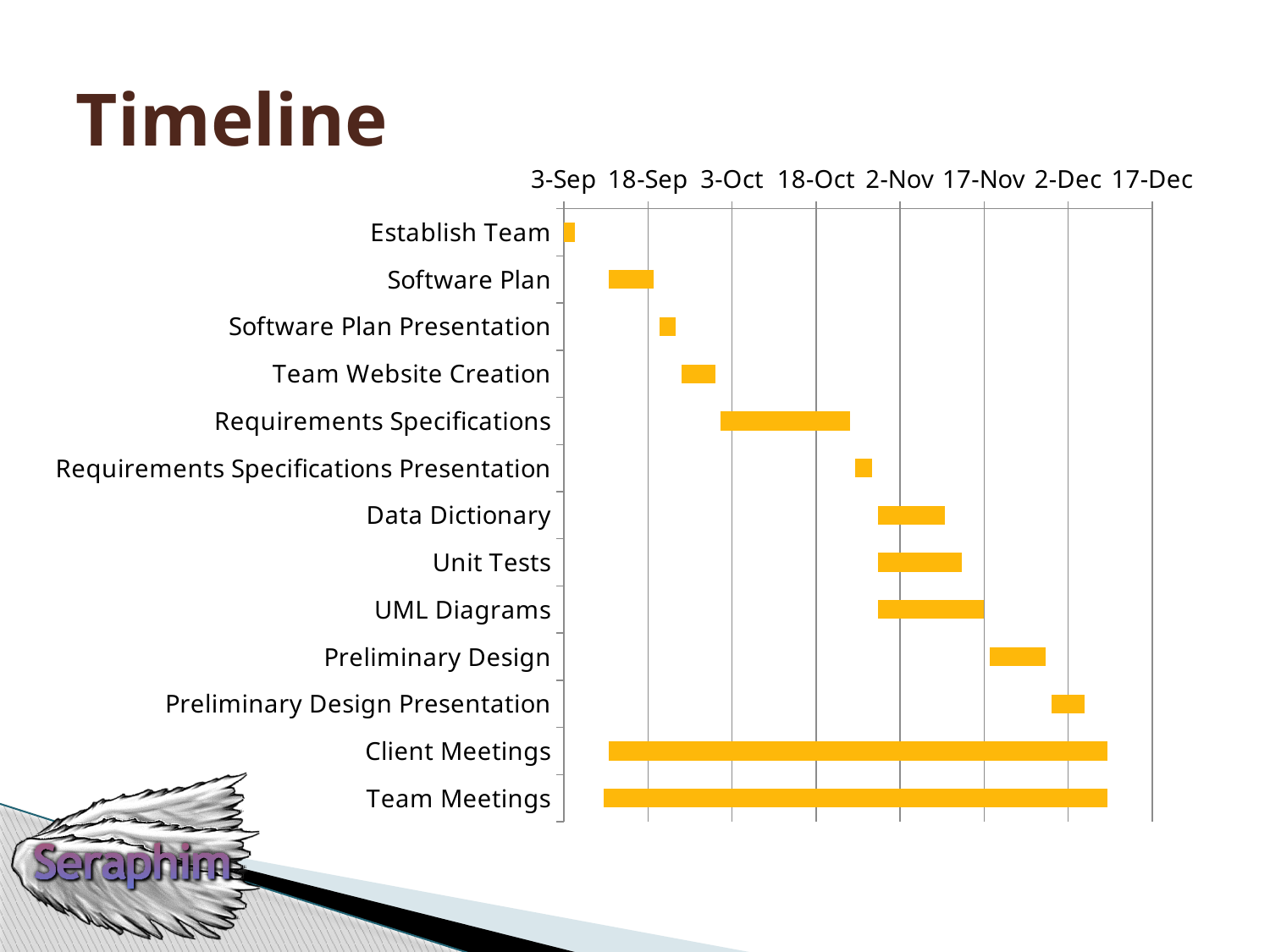
Does the Unit Tests bar end before or after 17-Nov? before Which task has the shortest bar in the Timeline chart? Establish Team What is the first date label on the horizontal axis of the Timeline chart? 3-Sep Which task has the longer bar, Requirements Specifications or Team Website Creation? Requirements Specifications What kind of chart is shown on the Timeline slide? Bar chart How many tasks are listed on the vertical axis of the Timeline chart? 13 Which task has the longer bar, UML Diagrams or Data Dictionary? UML Diagrams Does the Software Plan bar start before or after 18-Sep? before What is the last date label on the horizontal axis of the Timeline chart? 17-Dec Does the Team Website Creation bar end before or after 3-Oct? before